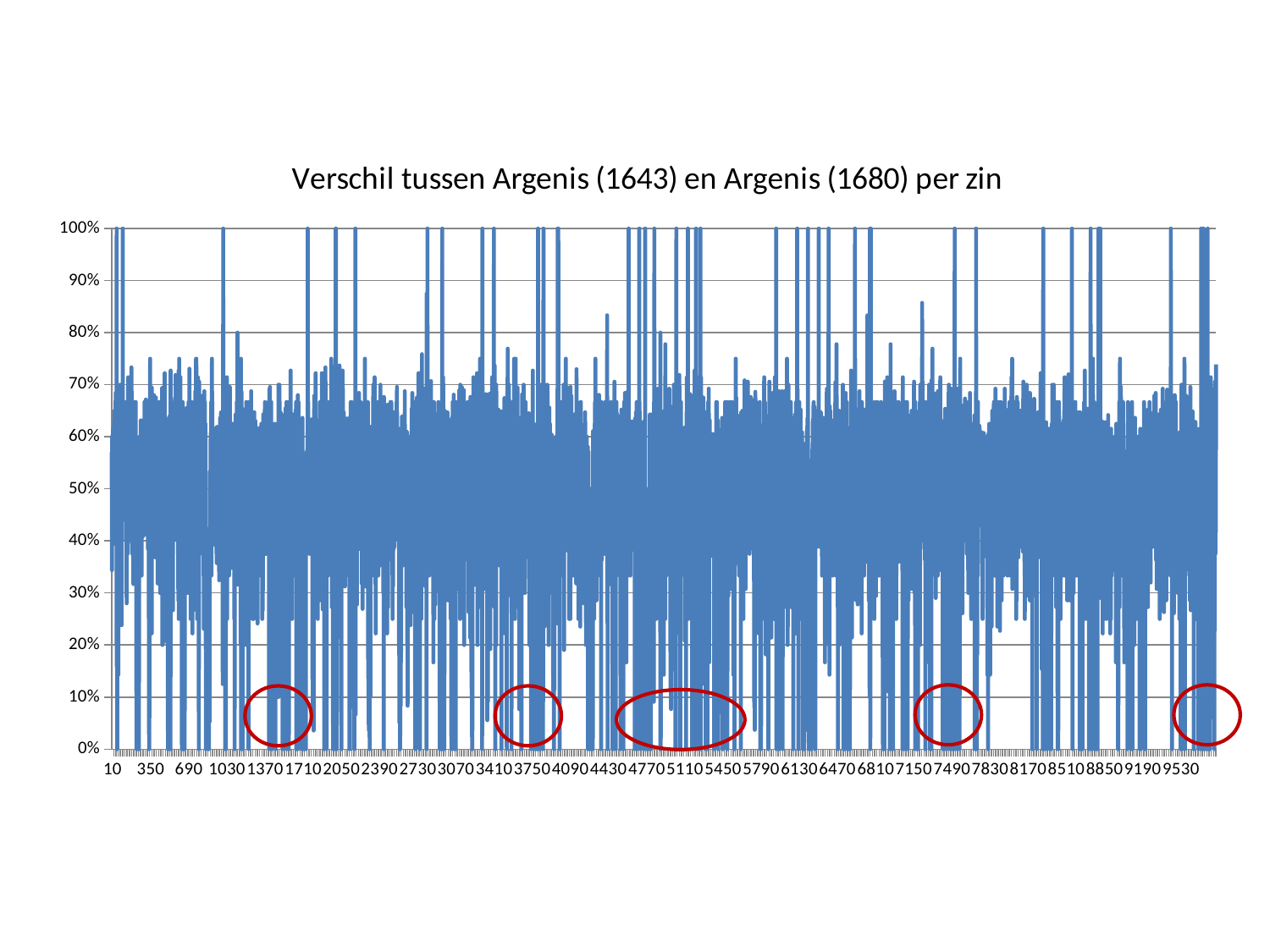
What is the title of the chart? Verschil tussen Argenis (1643) en Argenis (1680) per zin What is the highest value shown on the vertical axis of the chart? 100% What type of chart is shown on the slide? line chart What is the lowest value reached by the plotted data in the chart? 0% What is the last label printed on the horizontal axis of the chart? 9530 What is the highest value reached by the plotted data in the chart? 100% How many data series are plotted in the chart? 1 What is the first label on the horizontal axis of the chart? 10